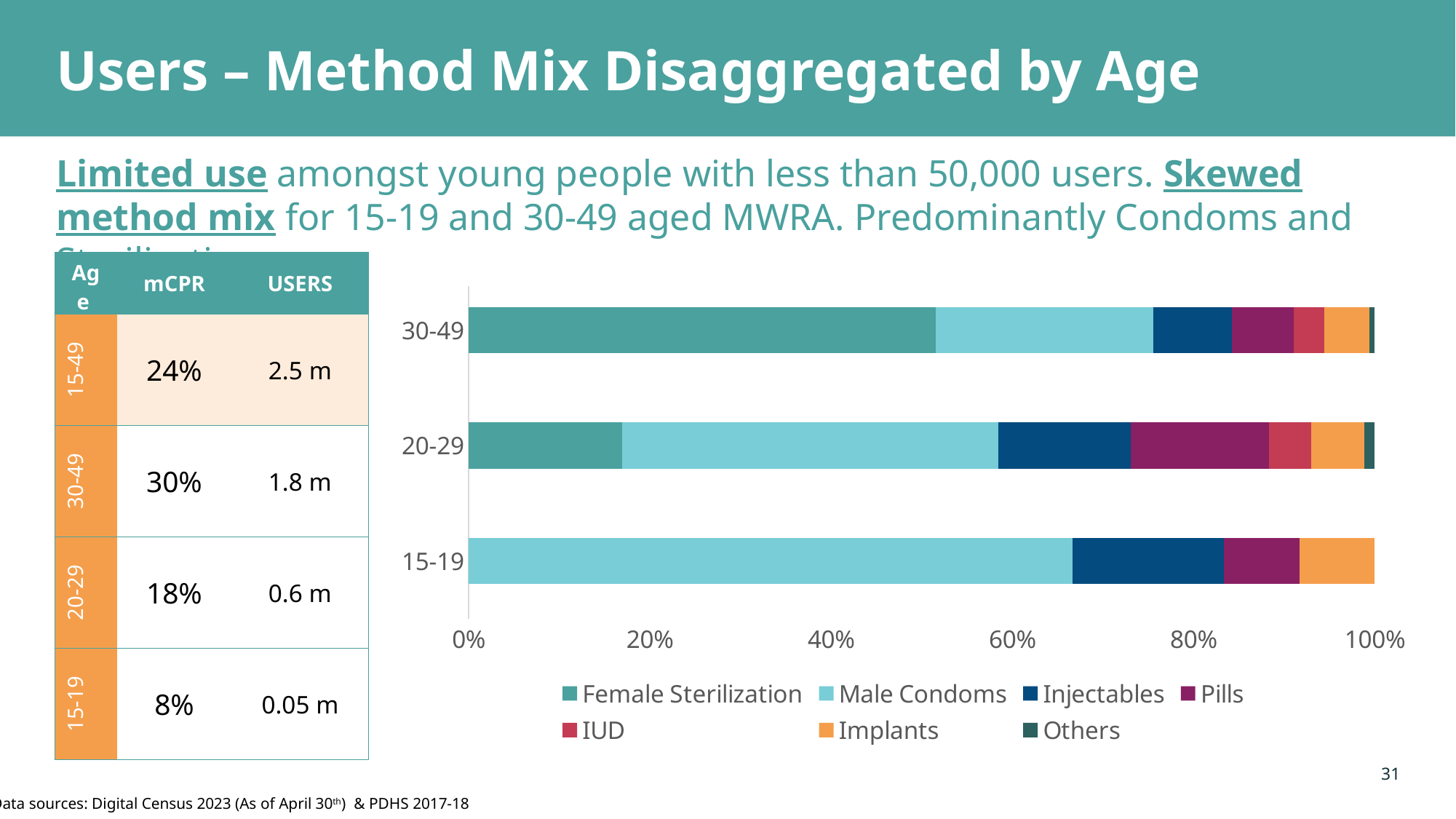
Is the Female Sterilization share for the 30-49 age group greater or less than 40%? greater How many series does the chart legend list? 7 Which series is listed first in the chart legend? Female Sterilization Which age group has a larger Pills share, 20-29 or 30-49? 20-29 Is the Male Condoms share for the 15-19 age group greater or less than 60%? greater Which age group has a larger Female Sterilization share, 30-49 or 20-29? 30-49 How many age groups are plotted in the chart? 3 Which age group has the smallest Female Sterilization share in the chart? 15-19 Which age group has the largest Female Sterilization share in the chart? 30-49 Is the Female Sterilization share for the 20-29 age group greater or less than 20%? less Which age group has the largest Male Condoms share in the chart? 15-19 What kind of chart is shown on the slide? Stacked bar chart